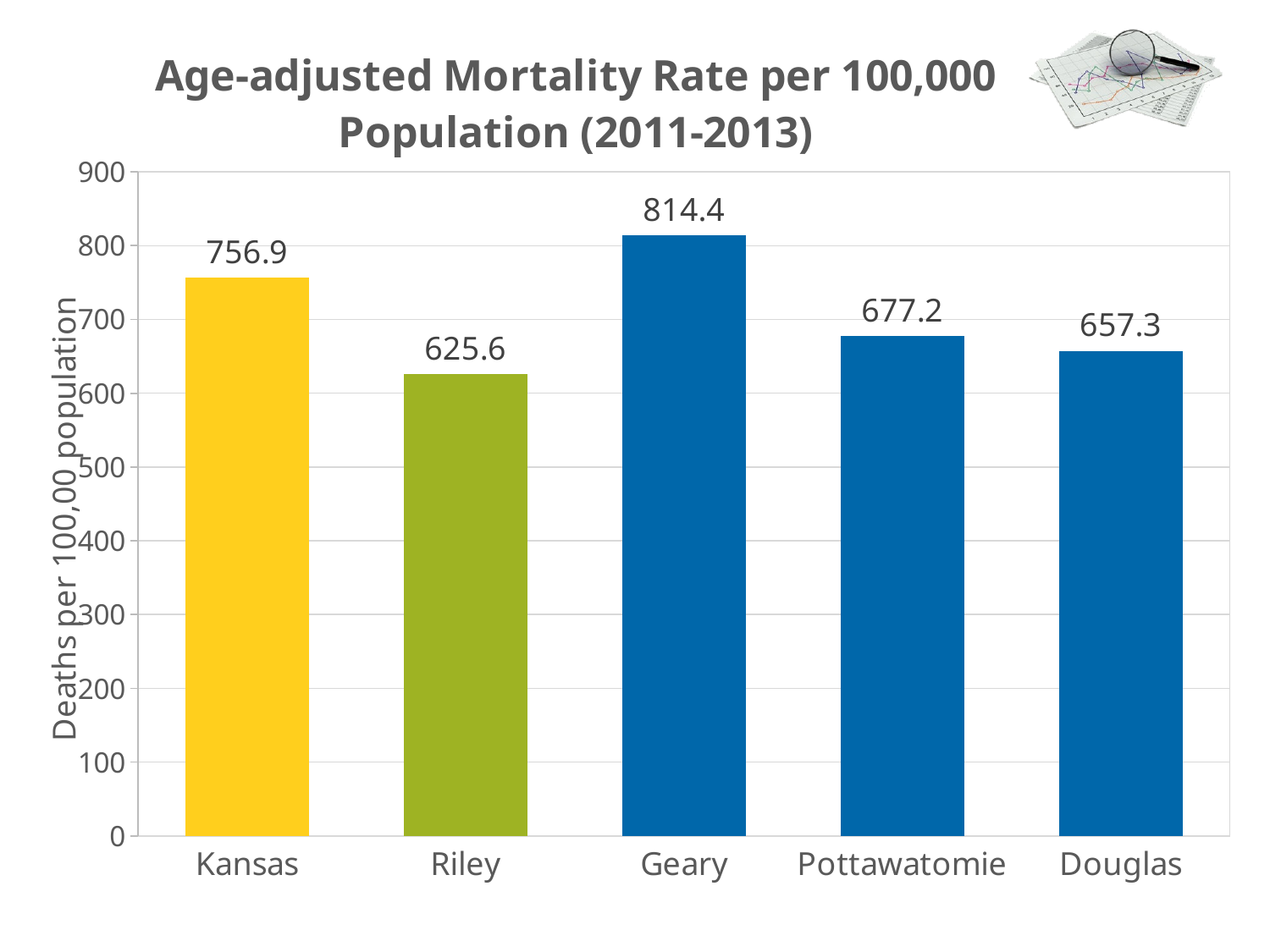
What is the age-adjusted mortality rate for Pottawatomie? 677.2 Which has a higher mortality rate, Pottawatomie or Douglas? Pottawatomie What kind of chart is shown on the slide? bar chart What is the age-adjusted mortality rate for Kansas? 756.9 How many categories are shown on the x axis? 5 Which category has the lowest mortality rate? Riley What is the title of the chart? Age-adjusted Mortality Rate per 100,000 Population (2011-2013) Which category has the highest mortality rate? Geary What is the difference between the mortality rates of Geary and Riley? 188.8 What is the age-adjusted mortality rate for Riley? 625.6 What is the difference between the mortality rates of Kansas and Douglas? 99.6 Is the value for Geary greater or less than 800? greater